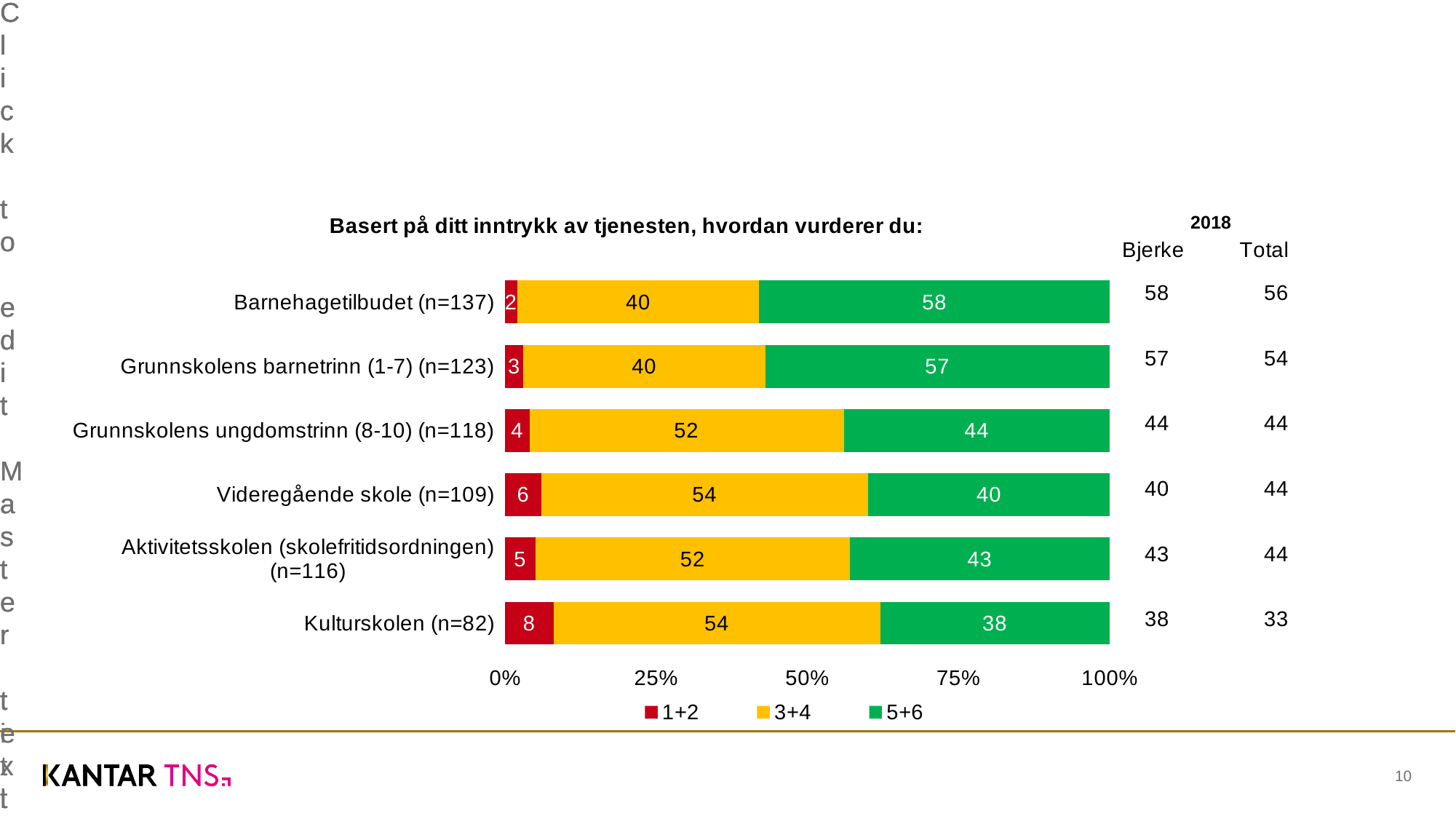
What is the value of the 5+6 segment for Barnehagetilbudet (n=137)? 58 What kind of chart is shown on the slide? Stacked bar chart What is the difference between the 5+6 values for Barnehagetilbudet (n=137) and Kulturskolen (n=82)? 20 Which is larger: the 3+4 value for Grunnskolens ungdomstrinn (8-10) (n=118) or the 3+4 value for Grunnskolens barnetrinn (1-7) (n=123)? Grunnskolens ungdomstrinn (8-10) (n=118) Which category has the highest 5+6 value? Barnehagetilbudet (n=137) Which category has the lowest 5+6 value? Kulturskolen (n=82) What is the value of the 3+4 segment for Videregående skole (n=109)? 54 What colour represents the 1+2 series in the legend? Red What is the total of the stacked bar for Aktivitetsskolen (skolefritidsordningen) (n=116)? 100 How many series does the legend list? 3 How many categories are shown in the chart? 6 What is the value of the 1+2 segment for Kulturskolen (n=82)? 8